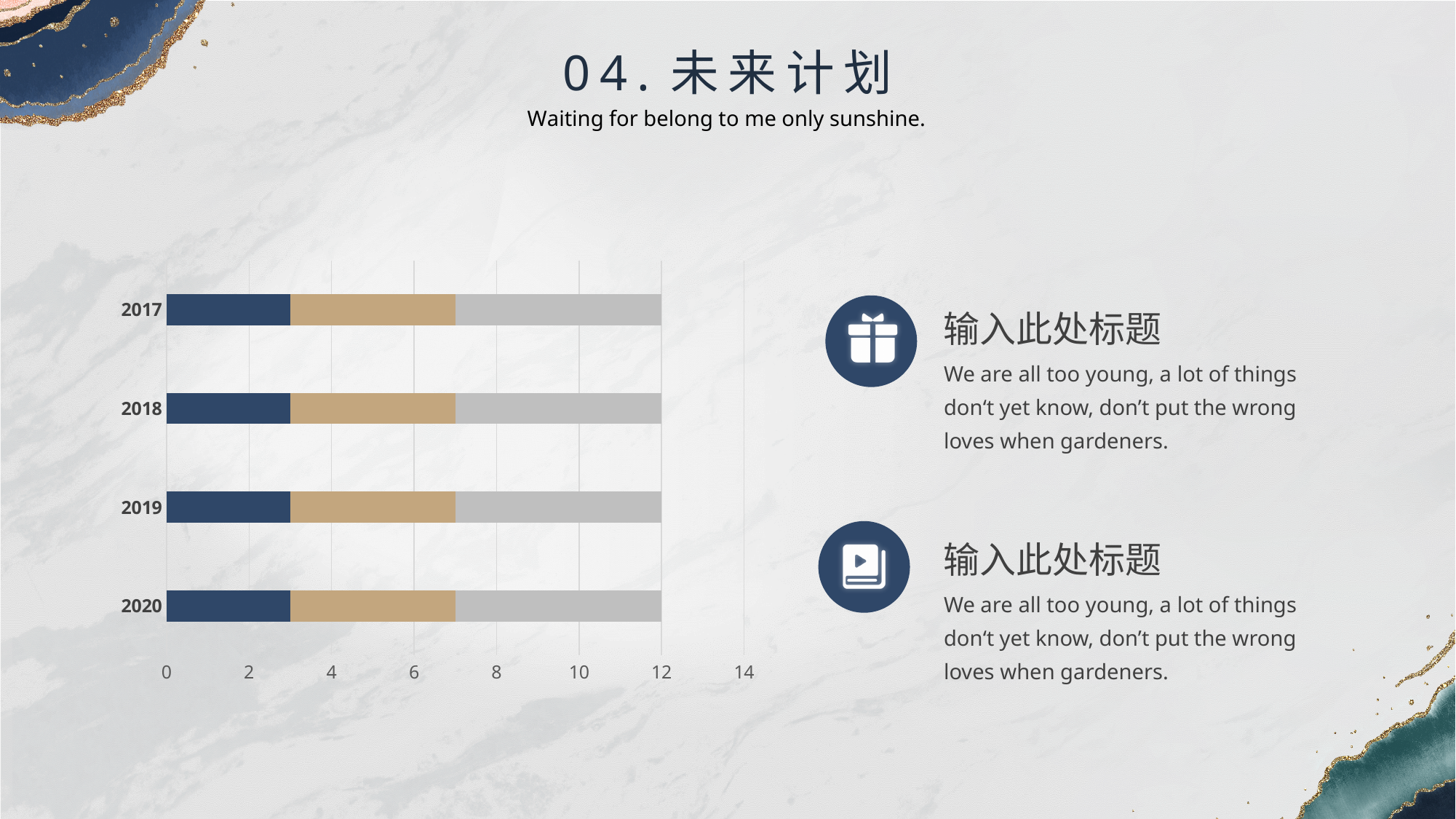
Is the first (dark blue) segment of the 2017 bar greater or less than 4? less Is the total of the stacked bar for 2018 greater or less than 10? greater What is the highest value shown on the horizontal axis? 14 Is the total of the stacked bar for 2019 greater or less than 14? less What is the total length of the stacked bar for 2017? 12 What kind of chart is shown on the slide? bar chart What is the total length of the stacked bar for 2020? 12 How many coloured segments make up each stacked bar? 3 Do the bar totals rise, fall, or stay the same from 2017 to 2020? stay the same How many categories (years) are shown on the chart? 4